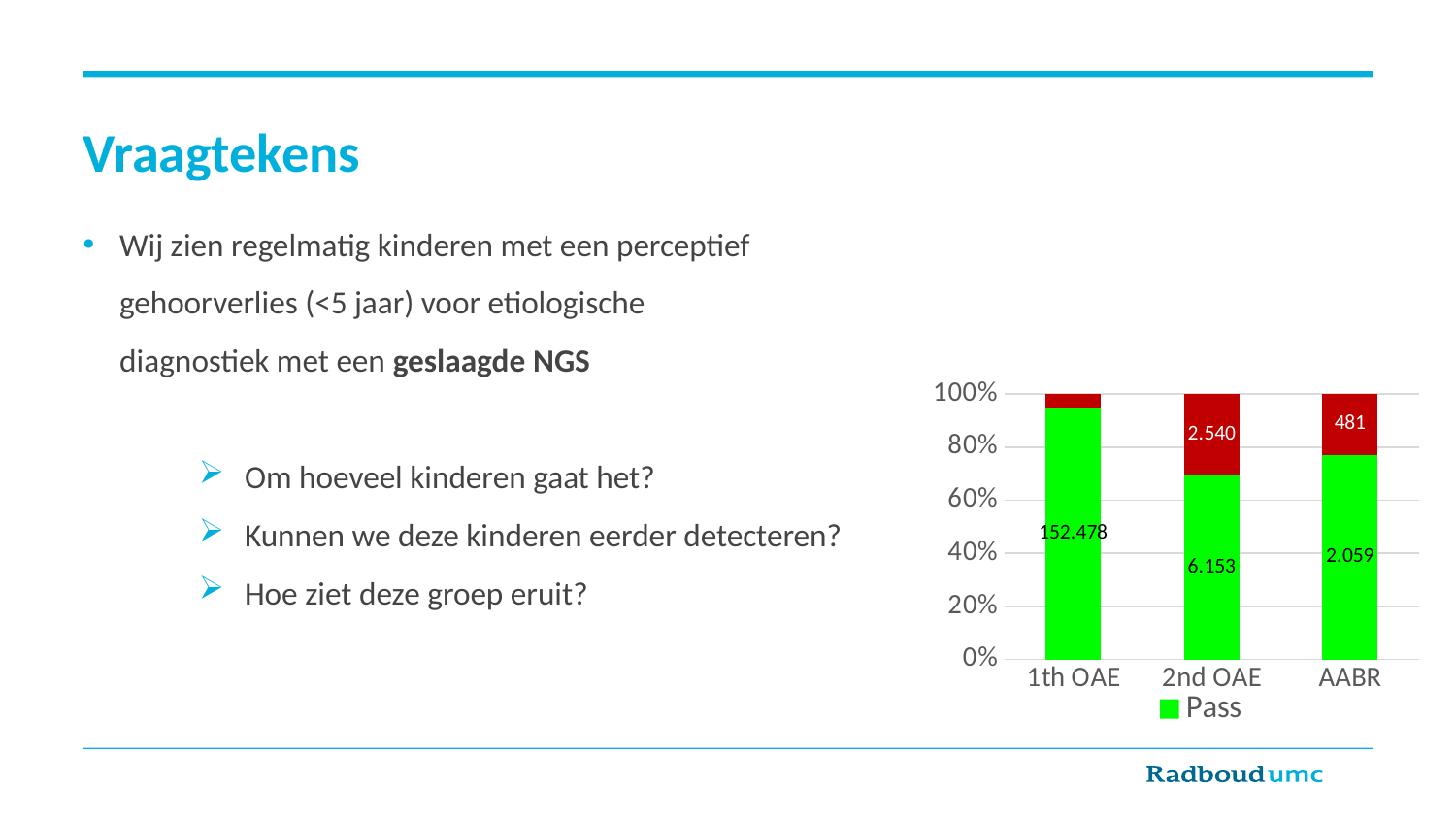
What value is printed on the red segment of the AABR bar? 481 What is the Pass value shown for AABR? 2.059 What kind of chart is shown on the slide? stacked bar chart What is the difference between the Pass value (6.153) and the red segment value (2.540) for 2nd OAE? 3.613 Is the Pass share of the 1th OAE bar greater or less than 80%? greater Which category has the highest Pass value? 1th OAE What is the Pass value shown for 1th OAE? 152.478 What value is printed on the red segment of the 2nd OAE bar? 2.540 How many categories are shown on the x axis? 3 Which is larger, the Pass value for 2nd OAE or for AABR? 2nd OAE Which entry does the chart legend list? Pass What is the Pass value shown for 2nd OAE? 6.153